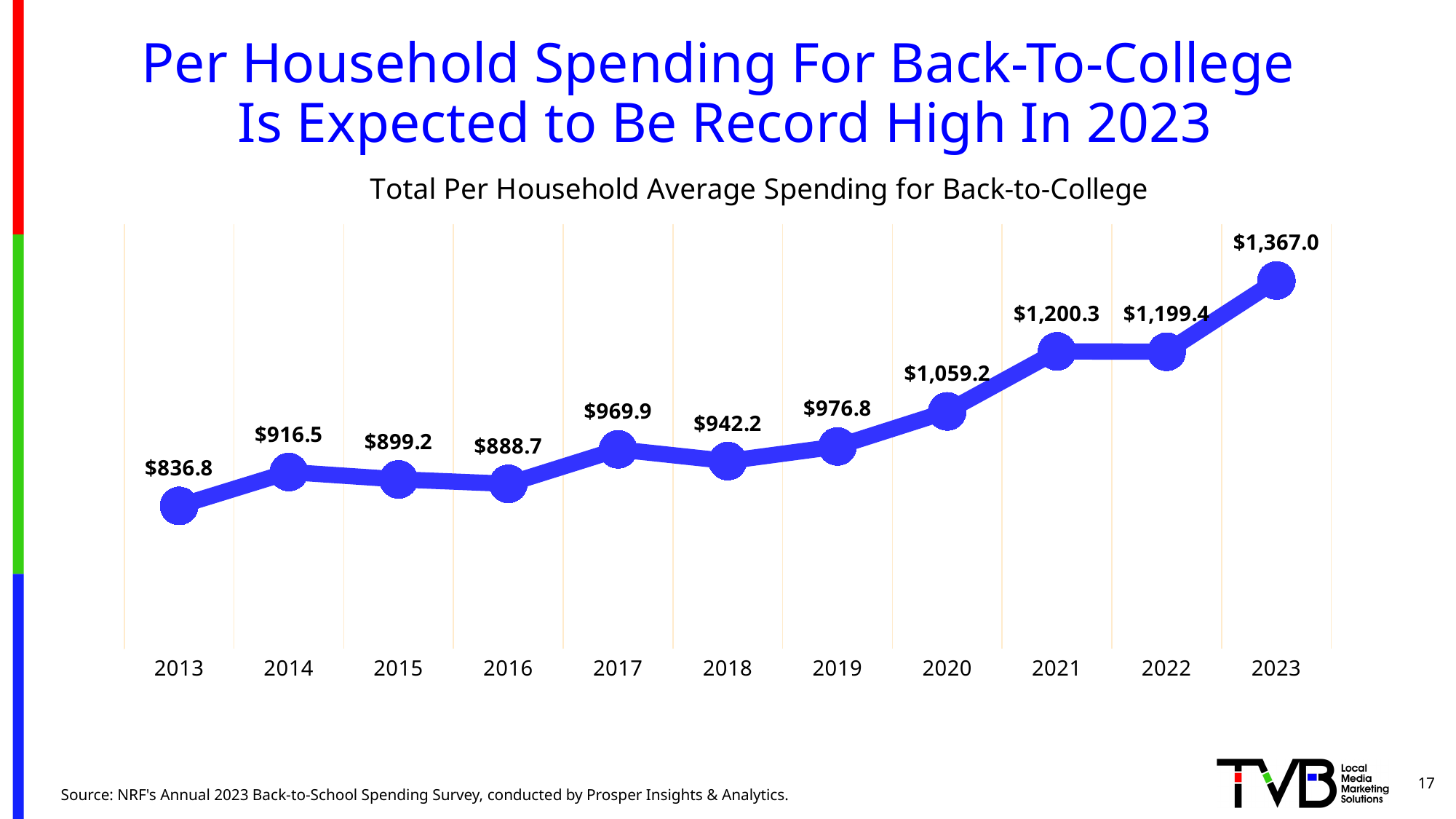
What is the total per household average spending for back-to-college in 2023? $1,367.0 Which year has higher per household spending, 2017 or 2018? 2017 Does per household spending generally rise or fall from 2013 to 2023? Rise What is the title of the chart? Total Per Household Average Spending for Back-to-College What is the per household spending value shown for 2020? $1,059.2 What is the difference between the 2023 and 2022 per household spending values? $167.6 How many years are plotted on the chart? 11 Which year has the highest per household spending? 2023 What kind of chart is shown on the slide? Line chart What is the difference between the 2014 and 2013 per household spending values? $79.7 Which year has the lowest per household spending? 2013 What is the per household spending value shown for 2013? $836.8